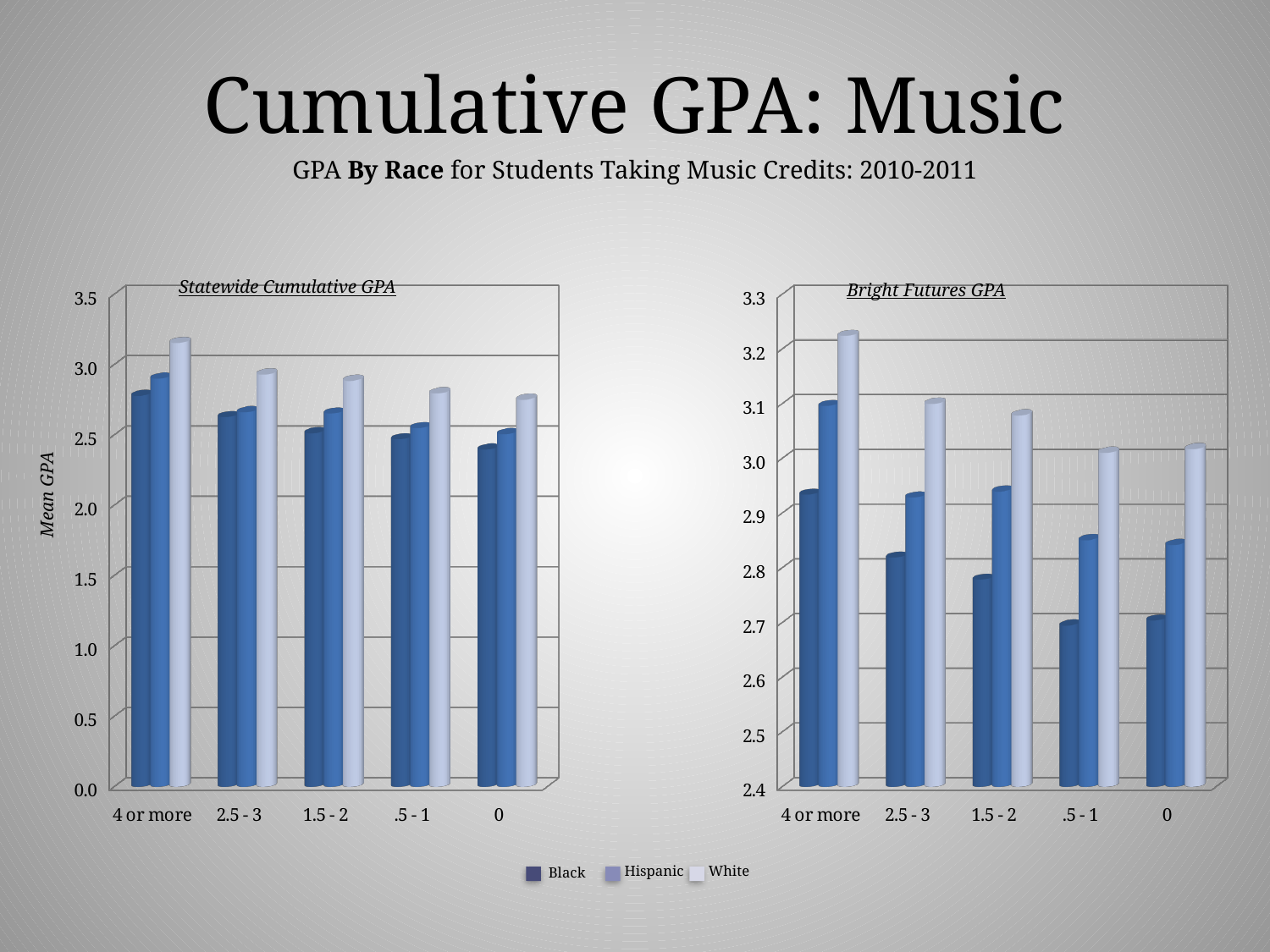
What kind of chart is the Statewide Cumulative GPA chart? bar chart How many categories are shown on the x axis of the Bright Futures GPA chart? 5 How many series does the legend list? 3 In the Bright Futures GPA chart, is the value for Black in the '1.5 - 2' category greater or less than 2.8? less In the Bright Futures GPA chart, which series has the lowest bar in the '1.5 - 2' category? Black In the Statewide Cumulative GPA chart, is the value for Black in the '0' category greater or less than 2.5? less In the Statewide Cumulative GPA chart, is the value for White in the '4 or more' category greater or less than 3.0? greater In the Statewide Cumulative GPA chart, which series has the highest bar in the '4 or more' category? White In the Bright Futures GPA chart, which is larger in the '2.5 - 3' category, the Hispanic bar or the Black bar? Hispanic In the Statewide Cumulative GPA chart, do the Black series values rise or fall from '4 or more' to '0' along the x axis? fall What is the title of the chart on the right side of the slide? Bright Futures GPA